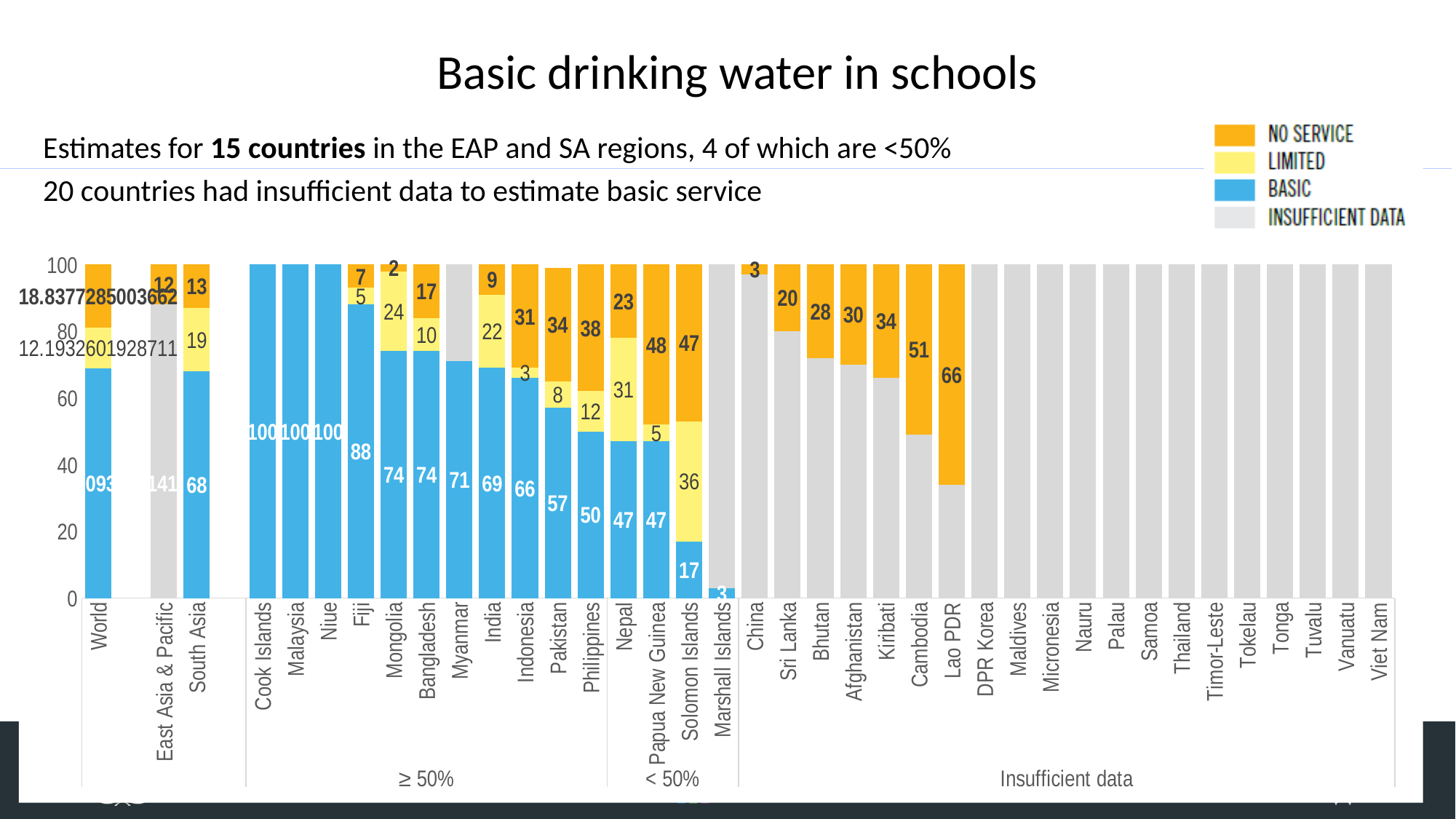
How many series does the legend list? 4 What is the difference between the BASIC values for Pakistan and the Philippines? 7 What is the NO SERVICE value for Lao PDR? 66 What is the BASIC value for Fiji? 88 What is the LIMITED value for Mongolia? 24 Which has the larger NO SERVICE value, Nepal or Indonesia? Indonesia How many countries are in the '< 50%' group? 4 Which country has the lowest BASIC value? Marshall Islands What is the total of the stacked bar for Fiji? 100 What is the LIMITED value for Solomon Islands? 36 What kind of chart is shown on the slide? Stacked bar chart Is the BASIC value for Bangladesh greater or less than 60? greater